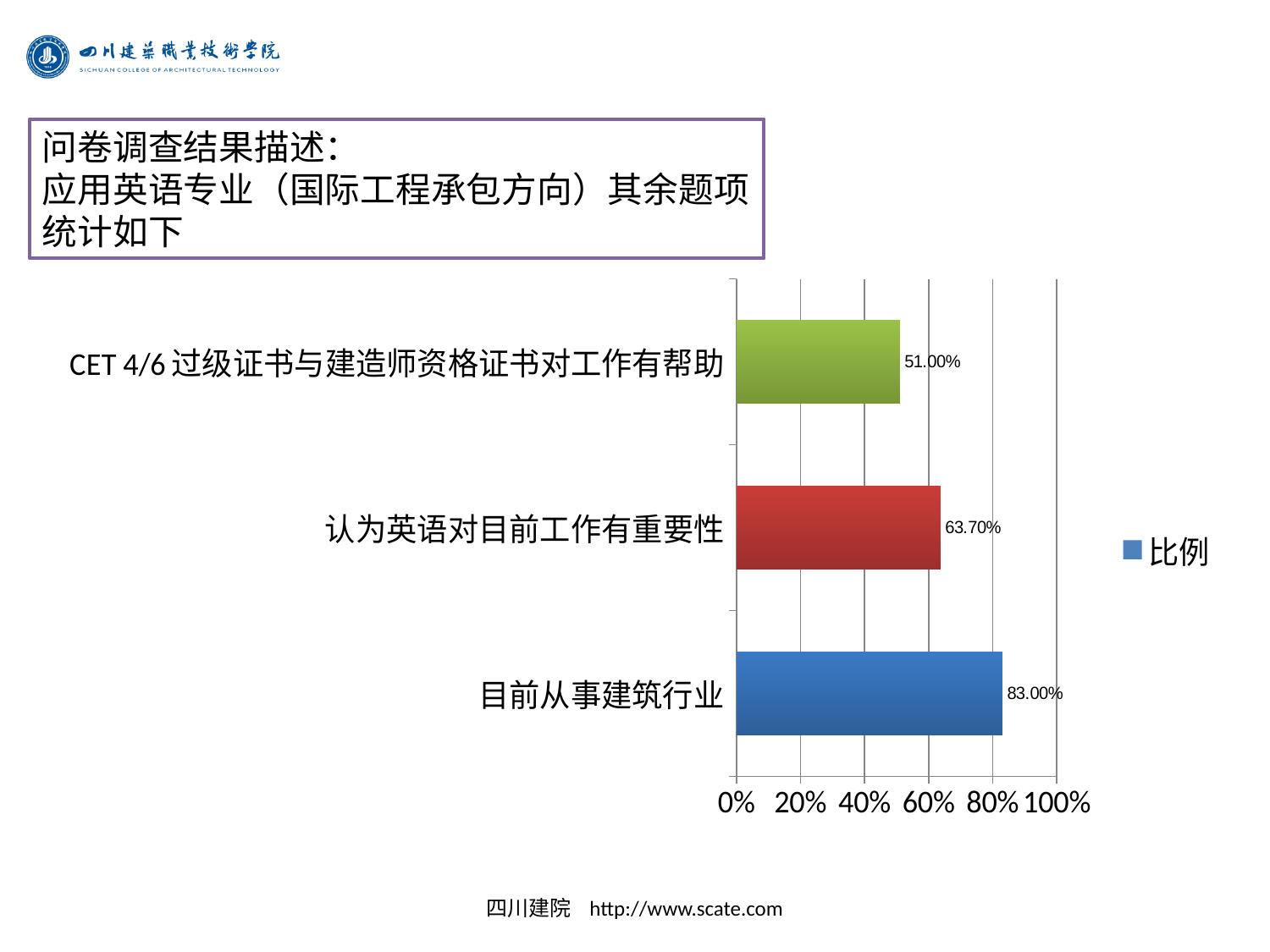
Is the value for 目前从事建筑行业 greater or less than 80%? greater What is the value for CET 4/6 过级证书与建造师资格证书对工作有帮助? 51.00% What is the value for 认为英语对目前工作有重要性? 63.70% Which is larger, the value for 认为英语对目前工作有重要性 or the value for CET 4/6 过级证书与建造师资格证书对工作有帮助? 认为英语对目前工作有重要性 What is the difference between the values for 目前从事建筑行业 and 认为英语对目前工作有重要性? 19.30% What is the value for 目前从事建筑行业? 83.00% Which category has the highest value? 目前从事建筑行业 How many series does the legend list? 1 Which category has the lowest value? CET 4/6 过级证书与建造师资格证书对工作有帮助 How many categories are shown in the chart? 3 What is the difference between the values for 认为英语对目前工作有重要性 and CET 4/6 过级证书与建造师资格证书对工作有帮助? 12.70% What kind of chart is shown on the slide? bar chart